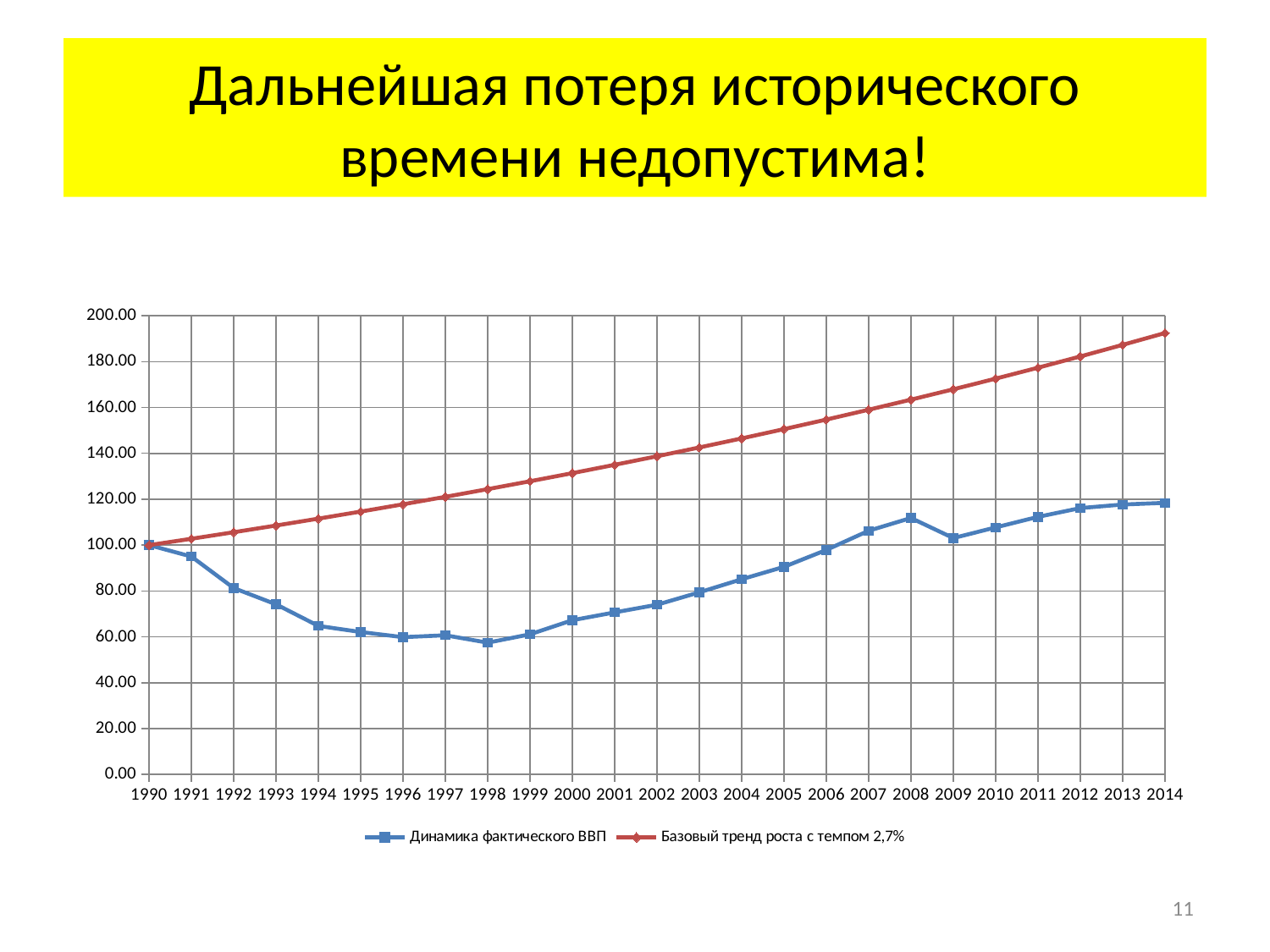
In 2005, which series has the higher value: Динамика фактического ВВП or Базовый тренд роста с темпом 2,7%? Базовый тренд роста с темпом 2,7% What kind of chart is shown on the slide? line chart Does the series Базовый тренд роста с темпом 2,7% rise or fall from 1990 to 2014? rise What is the value of Базовый тренд роста с темпом 2,7% in 1990? 100.00 Is the value of Динамика фактического ВВП in 2008 greater or less than 100? greater What colour is the line for Динамика фактического ВВП? blue Is the value of Базовый тренд роста с темпом 2,7% in 2014 greater or less than 180? greater Is the value of Динамика фактического ВВП in 1998 greater or less than 80? less How many series does the legend list? 2 In which year does Динамика фактического ВВП reach its lowest value? 1998 What is the value of Динамика фактического ВВП in 1990? 100.00 How many years are plotted along the x axis? 25